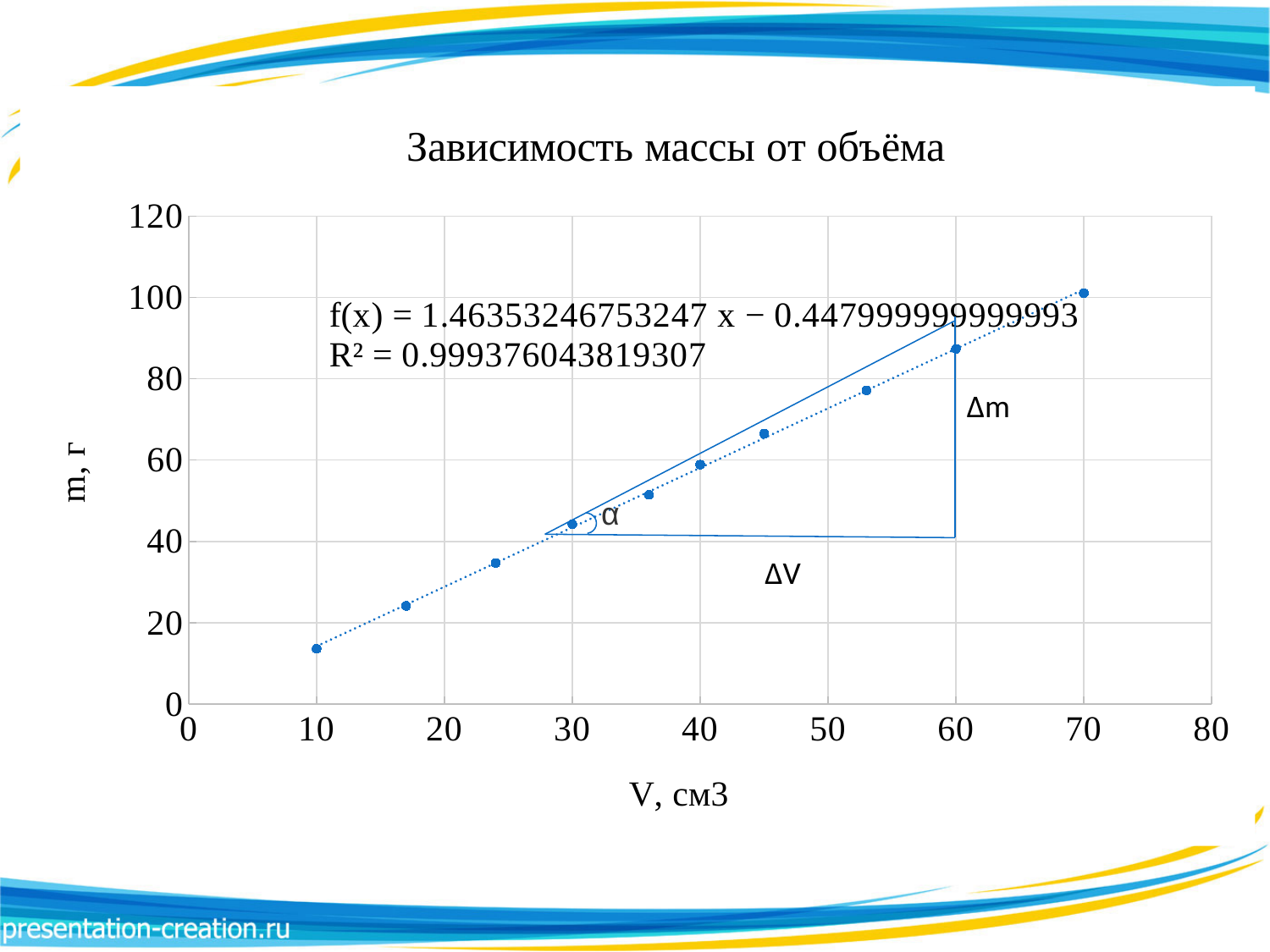
Is the value of m for V = 10 greater or less than 20? less Is the value of m for V = 30 greater or less than 60? less What kind of chart is shown on the slide? scatter chart Is the value of m for V = 70 greater or less than 80? greater Which has the larger mass value, the point at V = 60 or the point at V = 40? V = 60 How many data points are plotted on the chart? 10 What R² value is printed on the chart for the trendline? 0.999376043819307 Do the plotted values rise or fall as V increases along the x axis? rise What is the title of the chart? Зависимость массы от объёма At which value of V is the plotted mass lowest? 10 At which value of V is the plotted mass highest? 70